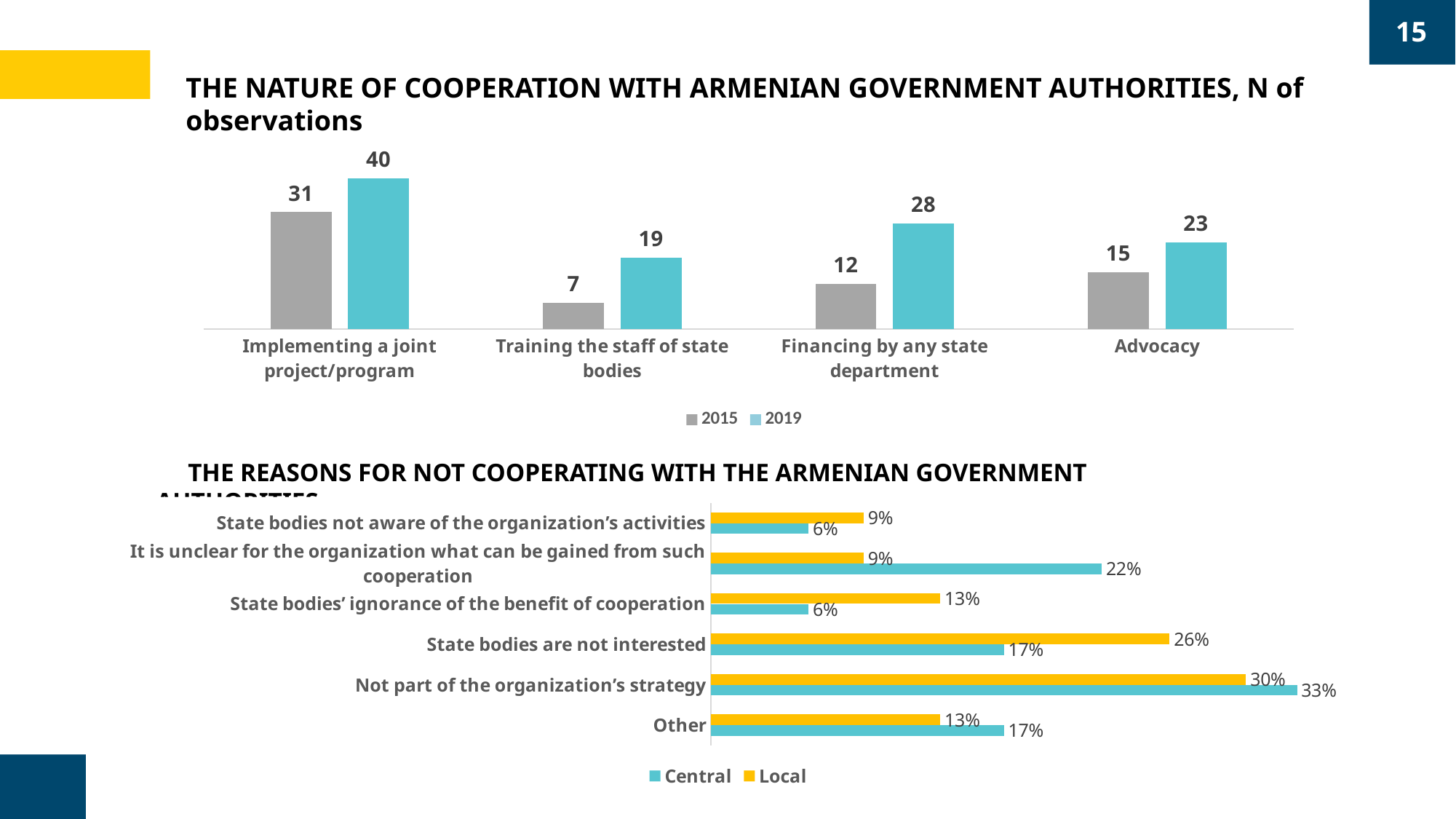
In the bottom chart on reasons for not cooperating, which is larger for 'Other': the Central value or the Local value? Central In the bottom chart on reasons for not cooperating, what is the Central value for 'It is unclear for the organization what can be gained from such cooperation'? 22% In the top chart on the nature of cooperation, how many categories are shown on the x axis? 4 In the top chart on the nature of cooperation, what is the difference between the 2019 and 2015 values for Financing by any state department? 16 In the top chart on the nature of cooperation, what is the 2019 value for Implementing a joint project/program? 40 In the top chart on the nature of cooperation, how many series does the legend list? 2 In the bottom chart on reasons for not cooperating, which reason has the highest Central value? Not part of the organization's strategy In the bottom chart on reasons for not cooperating, what is the Local value for 'State bodies are not interested'? 26% What kind of chart is the bottom chart on reasons for not cooperating? Bar chart In the top chart on the nature of cooperation, which category has the highest 2019 value? Implementing a joint project/program In the top chart on the nature of cooperation, what is the 2015 value for Training the staff of state bodies? 7 In the top chart on the nature of cooperation, which category has the lowest 2015 value? Training the staff of state bodies